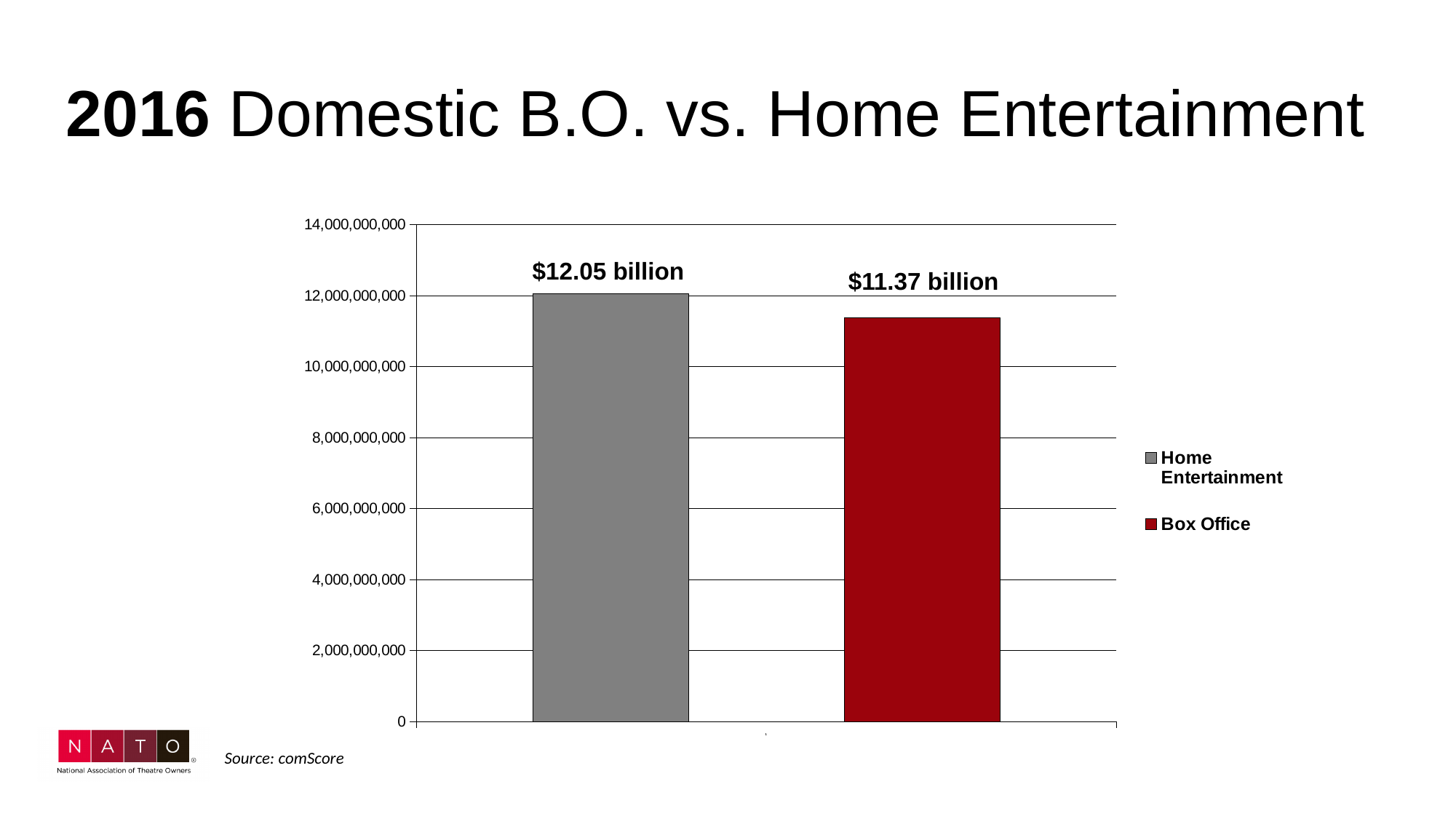
What kind of chart is shown on the slide? bar chart What is the value shown for Box Office? $11.37 billion What is the value shown for Home Entertainment? $12.05 billion Is the Box Office value larger or smaller than the Home Entertainment value? smaller What is the title of the slide? 2016 Domestic B.O. vs. Home Entertainment Which series has the higher value, Home Entertainment or Box Office? Home Entertainment Which series has the lower value? Box Office How many series does the legend list? 2 Is the value for Box Office greater or less than 12,000,000,000? less What is the difference between the Home Entertainment and Box Office values? $0.68 billion Is the value for Home Entertainment greater or less than 10,000,000,000? greater What colour is the Box Office bar? red